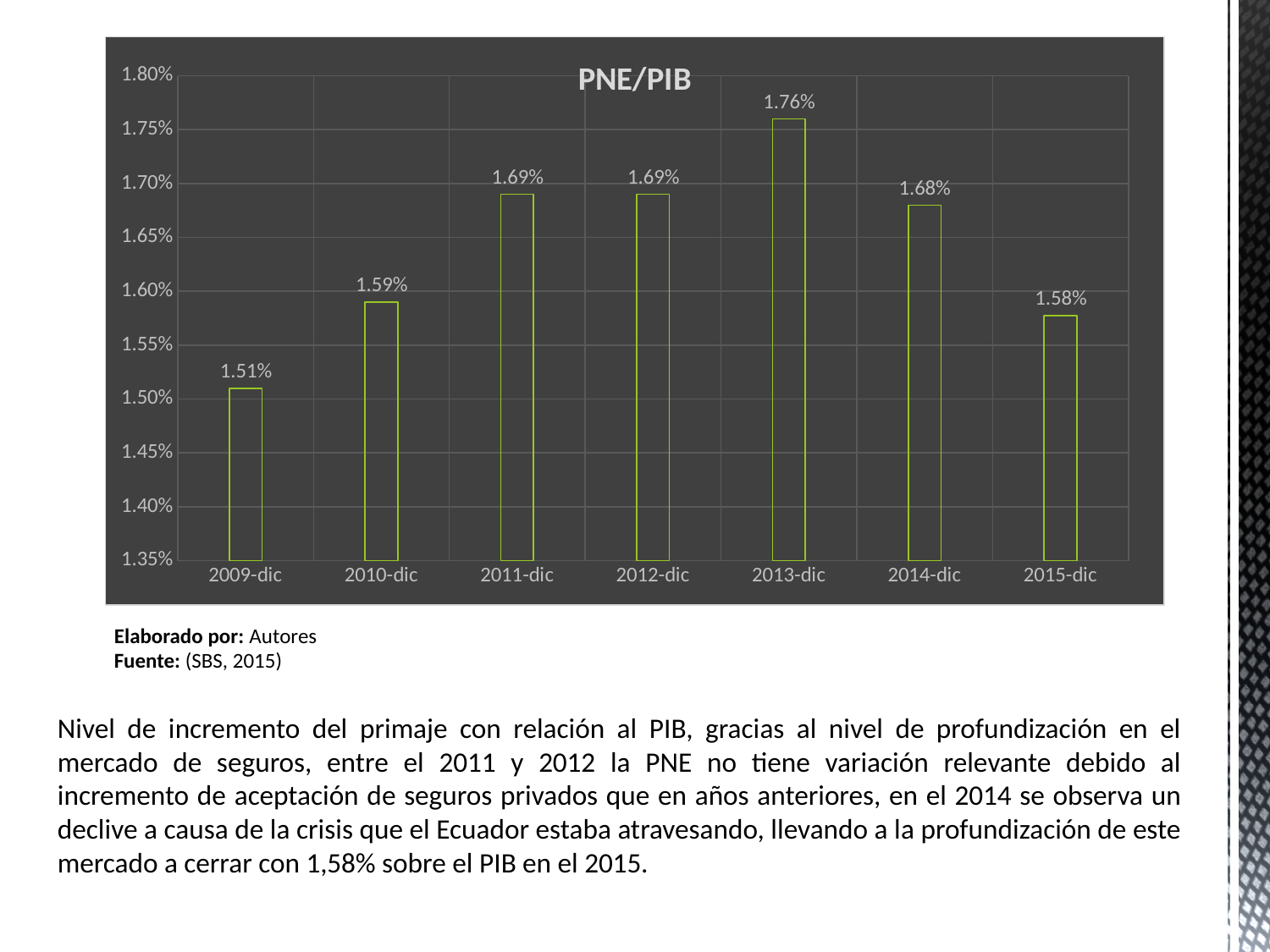
What is the title of the chart? PNE/PIB How many categories are shown on the x axis? 7 What kind of chart is this? bar chart What is the value for 2015-dic? 1.58% What is the value for 2013-dic? 1.76% Which category has the lowest value? 2009-dic What is the difference between the values for 2013-dic and 2014-dic? 0.08% Do the values rise or fall from 2009-dic to 2013-dic? rise Which category has the highest value? 2013-dic Which is larger, the value for 2010-dic or the value for 2015-dic? 2010-dic Is the value for 2014-dic greater or less than 1.65%? greater What is the value for 2009-dic? 1.51%